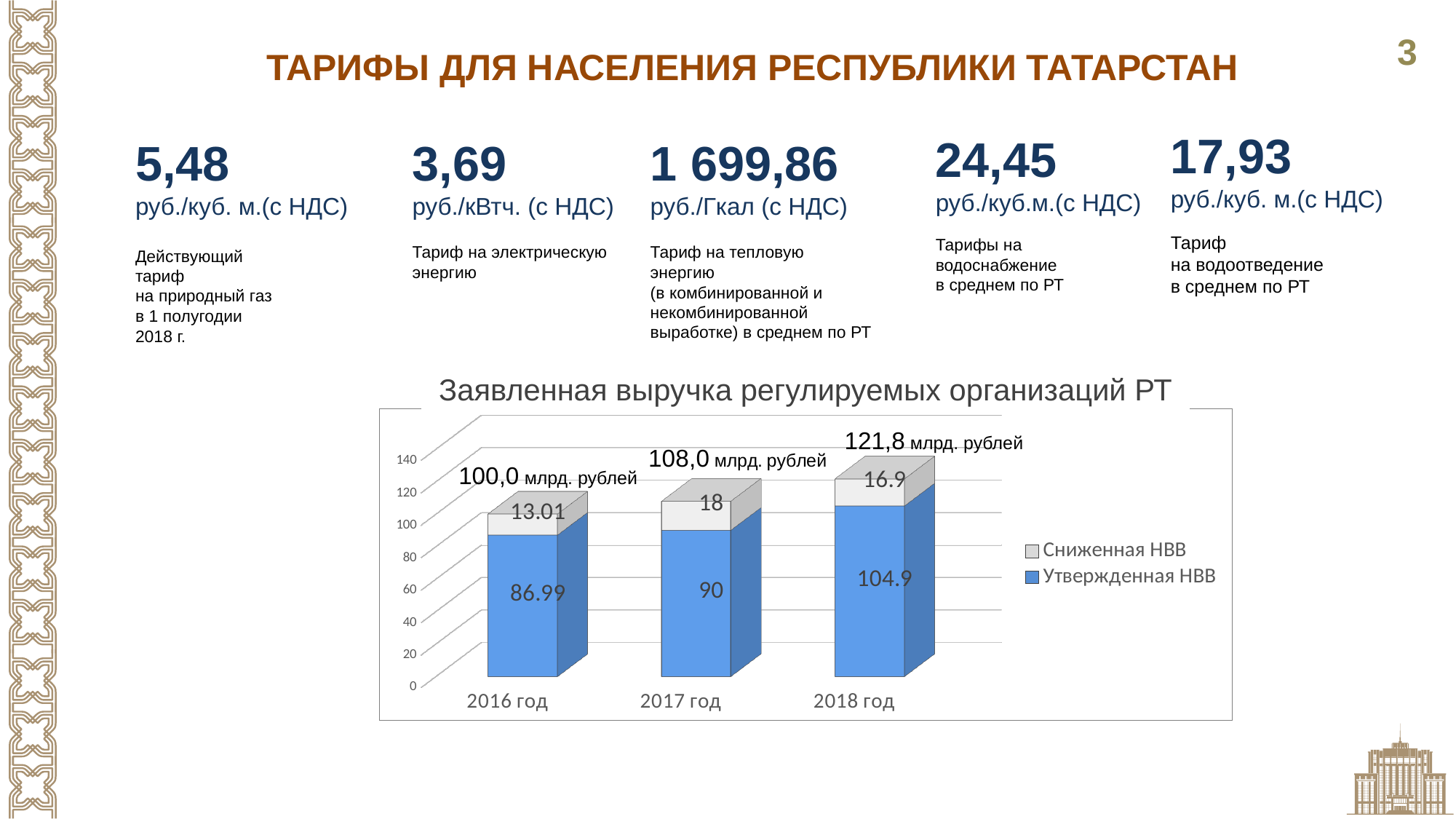
What type of chart is shown on the slide? stacked bar chart How many series does the legend list? 2 What is the value of Утвержденная НВВ for 2016 год? 86.99 Which year has the highest value of Утвержденная НВВ? 2018 год Does the total labelled above the bars rise or fall from 2016 год to 2018 год? rise What is the value of Утвержденная НВВ for 2018 год? 104.9 What is the total labelled above the stacked bar for 2017 год? 108,0 млрд. рублей Which year has the lowest value of Сниженная НВВ? 2016 год What is the difference between Утвержденная НВВ in 2018 год and 2017 год? 14.9 What is the value of Сниженная НВВ for 2017 год? 18 What is the value of Сниженная НВВ for 2018 год? 16.9 Is Сниженная НВВ larger in 2017 год or in 2018 год? 2017 год